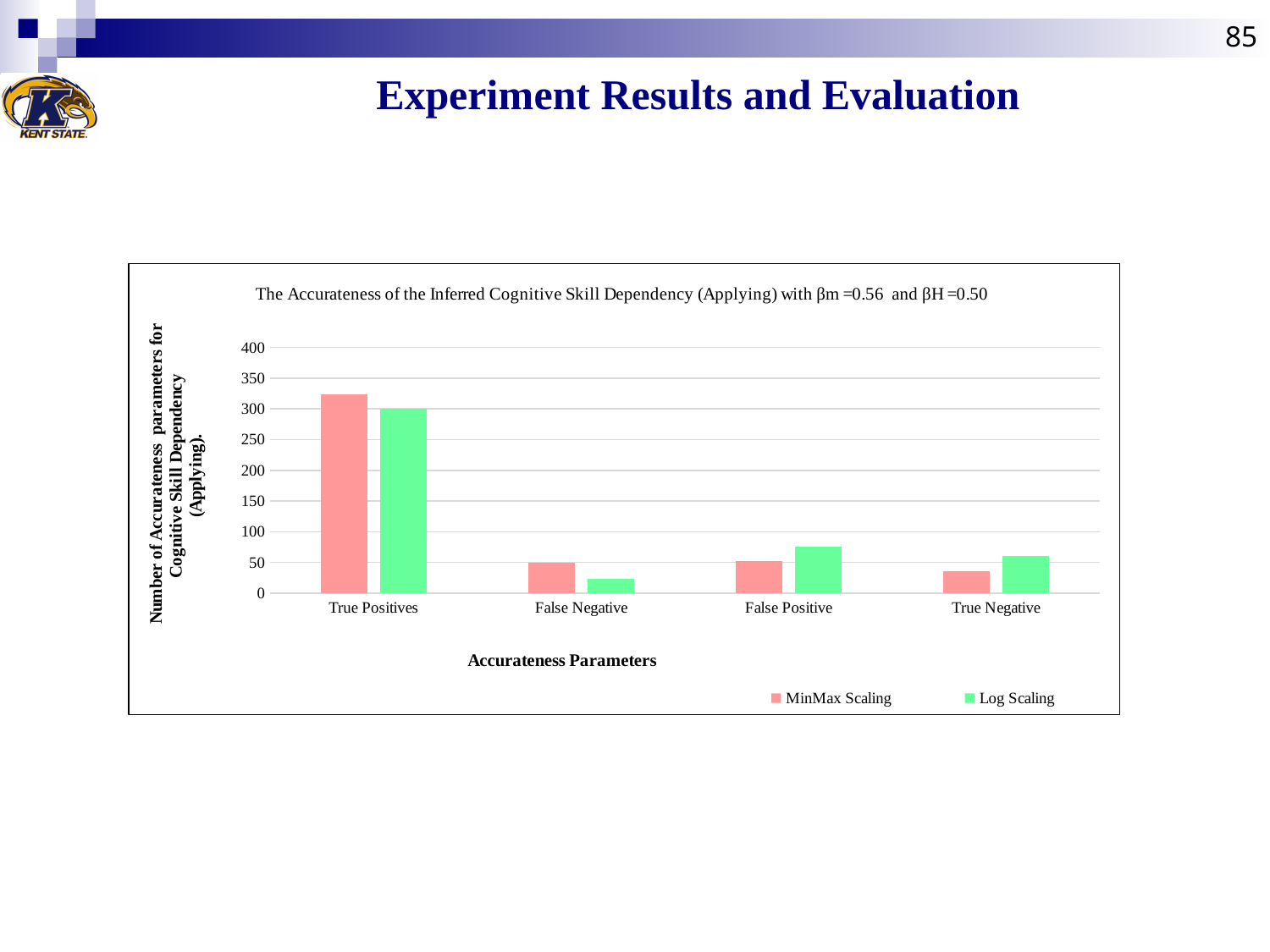
Is the MinMax Scaling value for True Negative greater or less than 50? less Which category has the lowest value for Log Scaling? False Negative How many categories are shown on the x axis of the chart? 4 Is the Log Scaling value for False Negative greater or less than 50? less For True Positives, which series has the larger value, MinMax Scaling or Log Scaling? MinMax Scaling How many series does the chart's legend list? 2 For False Positive, which series has the larger value, MinMax Scaling or Log Scaling? Log Scaling Which category has the highest value for MinMax Scaling? True Positives What is the label of the x axis of the chart? Accurateness Parameters What kind of chart is shown on the slide? bar chart For True Negative, which series has the larger value, MinMax Scaling or Log Scaling? Log Scaling Is the MinMax Scaling value for True Positives greater or less than 300? greater